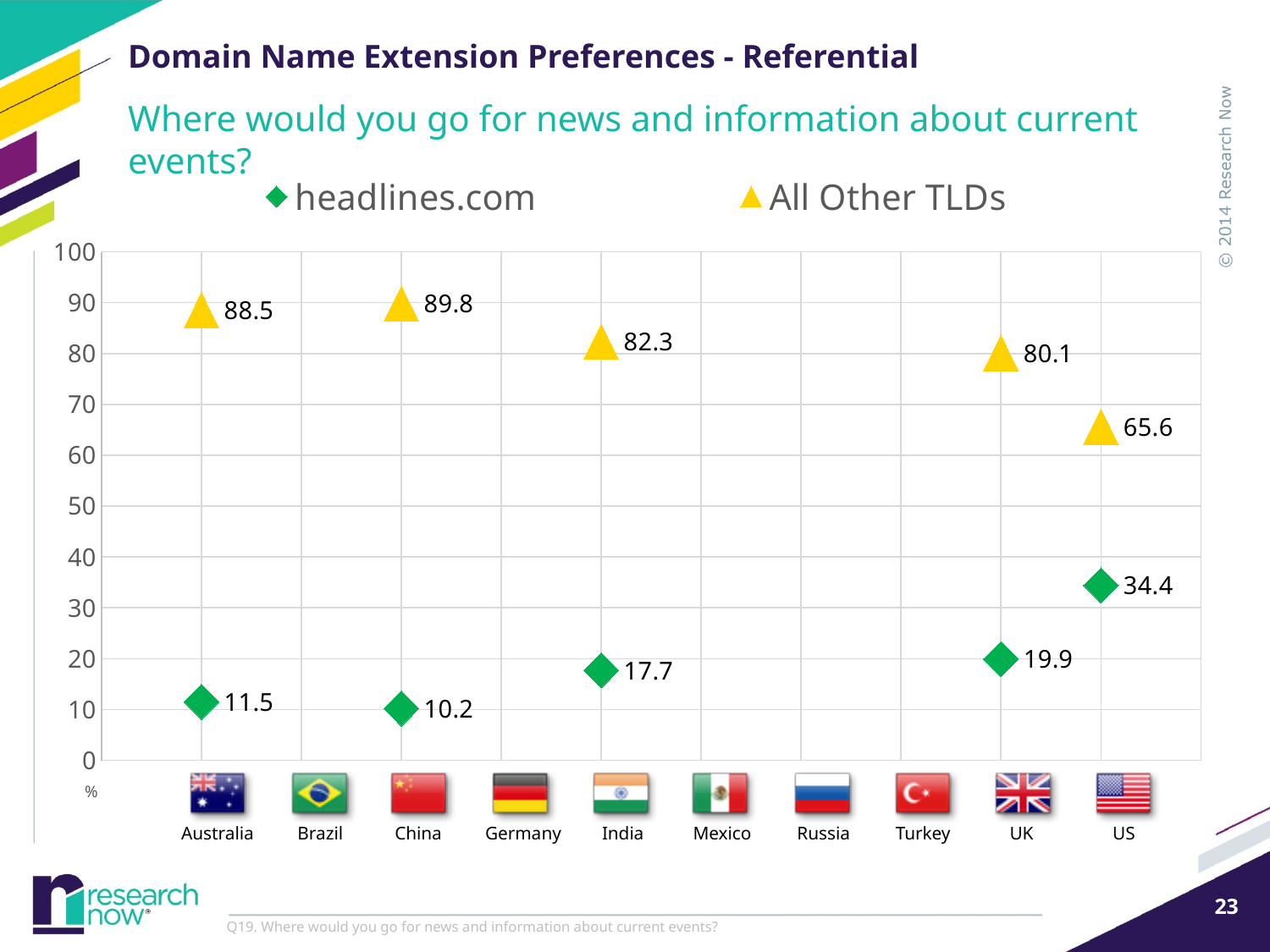
How many countries are listed along the x axis? 10 How many series does the legend list? 2 Which is larger, the headlines.com value for India or for the UK? UK Which country has the lowest value for headlines.com? China What is the value for headlines.com in the US? 34.4 What is the value for All Other TLDs in India? 82.3 What is the value for All Other TLDs in China? 89.8 What is the value for headlines.com in the UK? 19.9 What is the difference between the All Other TLDs value and the headlines.com value for Australia? 77 Which country has the lowest value for All Other TLDs? US What marker shape is used for the All Other TLDs series? Yellow triangle Which country has the highest value for headlines.com? US